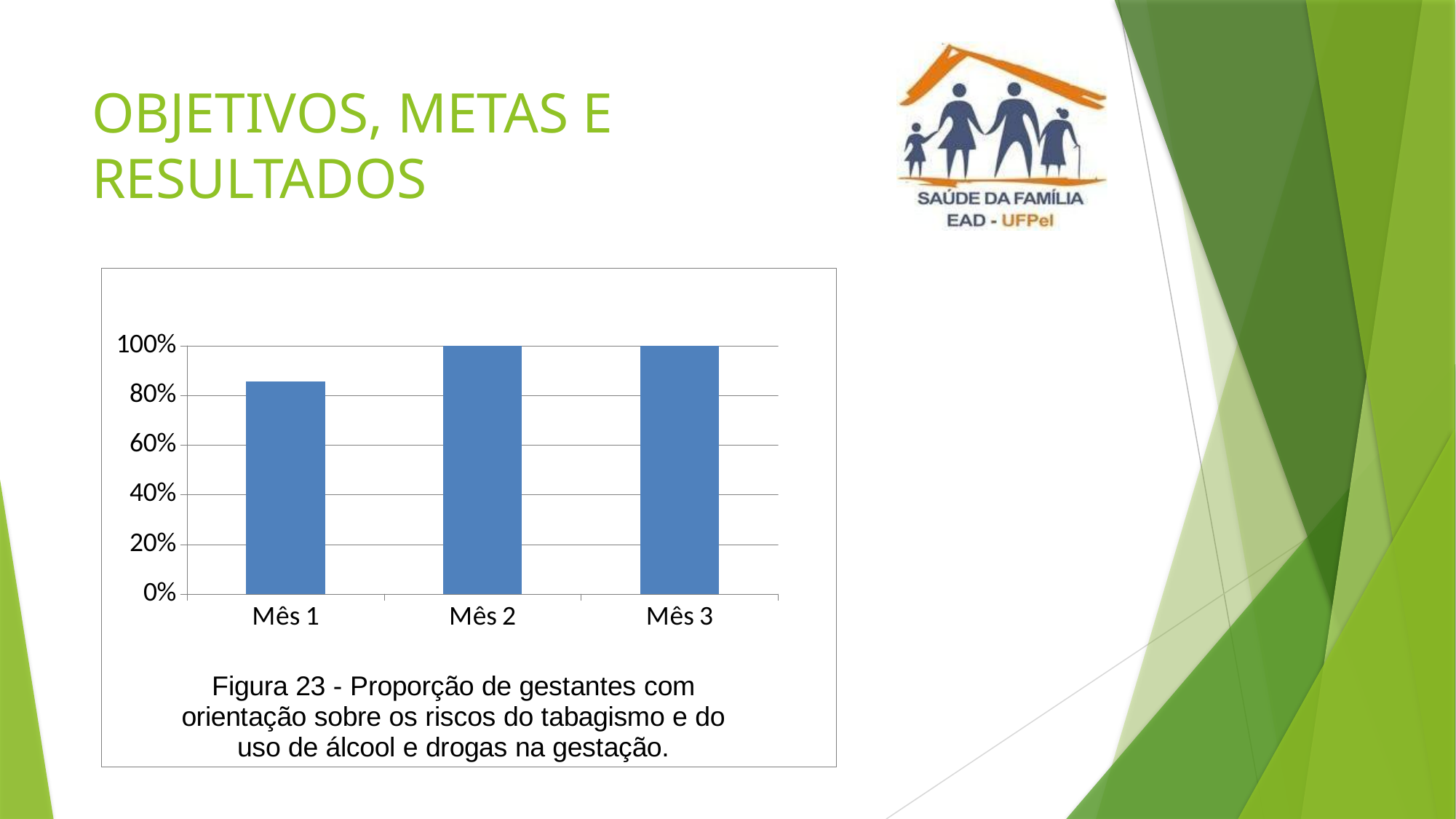
Do the values rise or fall from Mês 1 to Mês 2? rise Which is larger, the value for Mês 1 or the value for Mês 2? Mês 2 What figure number is given in the chart caption? Figura 23 Is the value for Mês 1 greater or less than 100%? less Is the value for Mês 1 greater or less than 80%? greater What kind of chart is shown on the slide? bar chart What is the value for Mês 3? 100% Which month has the lowest value? Mês 1 What colour are the bars in the chart? blue Which months reach 100%? Mês 2 and Mês 3 How many categories (months) are plotted on the chart? 3 What is the value for Mês 2? 100%